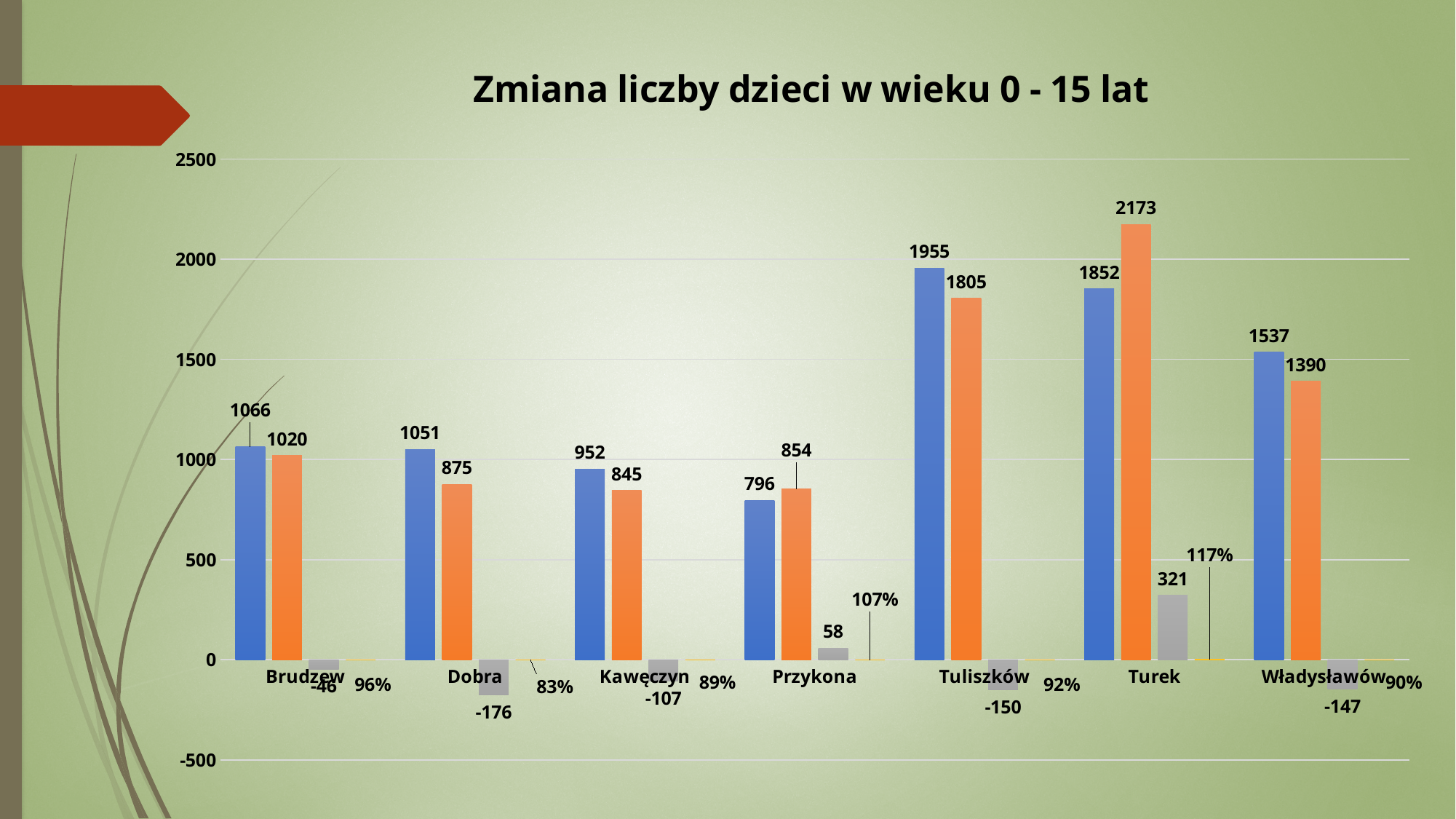
What is the difference between the blue bar and the orange bar for Władysławów? 147 Which category has the lowest blue bar? Przykona How many categories (municipalities) are shown on the x axis? 7 What type of chart is shown on the slide? bar chart What is the value of the orange bar for Turek? 2173 Is the value of the blue bar for Turek greater or less than 1500? greater Which category has the highest orange bar? Turek What is the value of the gray bar for Dobra? -176 What is the value of the blue bar for Tuliszków? 1955 Which is larger for Kawęczyn, the blue bar or the orange bar? the blue bar What percentage is shown for Przykona? 107% What is the title of the chart? Zmiana liczby dzieci w wieku 0 - 15 lat